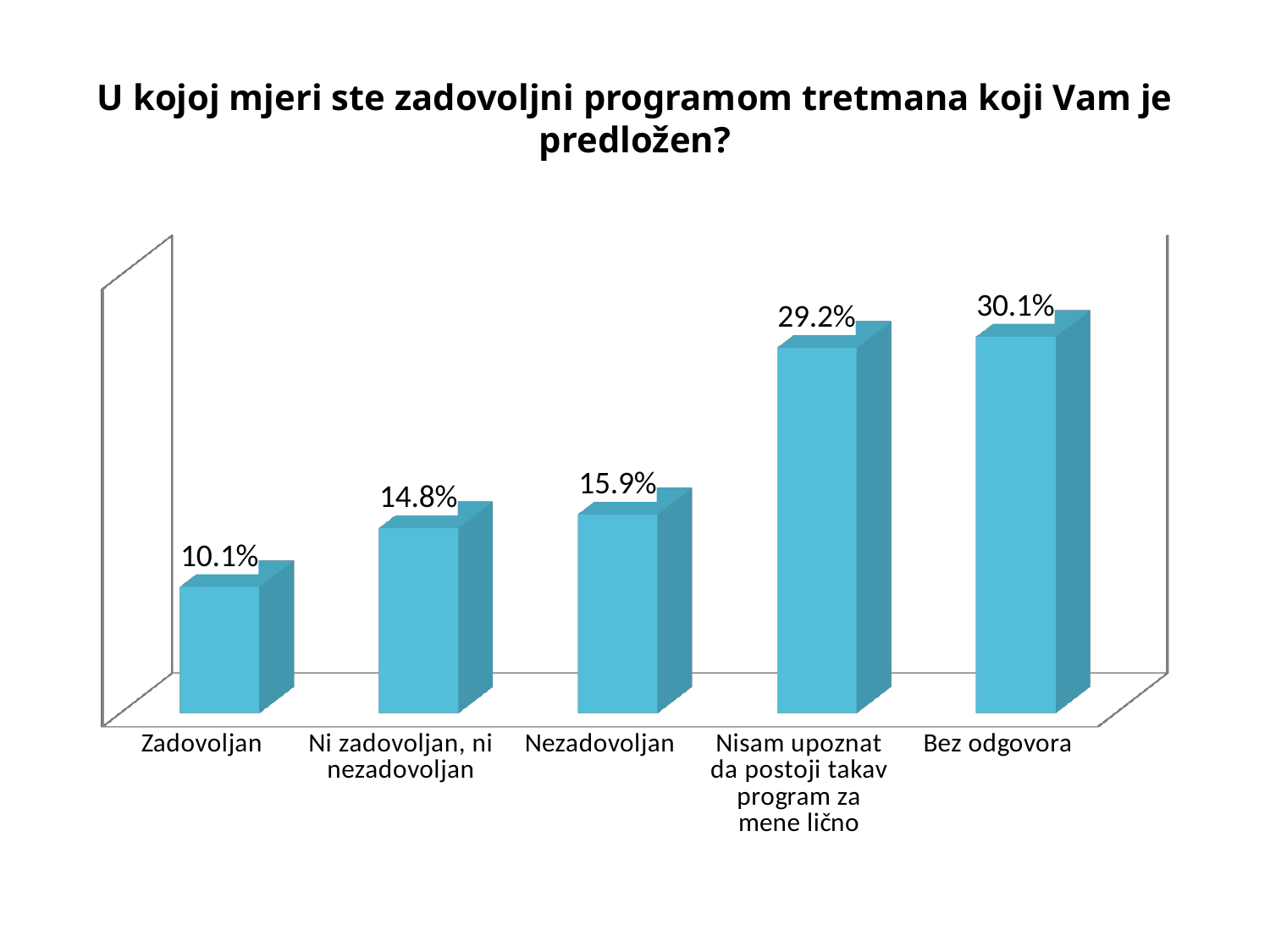
Which category has the highest value? Bez odgovora What is the value for Nisam upoznat da postoji takav program za mene lično? 29.2% What is the difference between the values for Nezadovoljan and Ni zadovoljan, ni nezadovoljan? 1.1% What is the value for Zadovoljan? 10.1% Which category has the lowest value? Zadovoljan How many categories are shown in the chart? 5 What is the value for Bez odgovora? 30.1% What is the value for Ni zadovoljan, ni nezadovoljan? 14.8% Which is larger, the value for Nezadovoljan or the value for Zadovoljan? Nezadovoljan What is the difference between the values for Bez odgovora and Zadovoljan? 20.0% What is the value for Nezadovoljan? 15.9% What kind of chart is shown on the slide? Bar chart